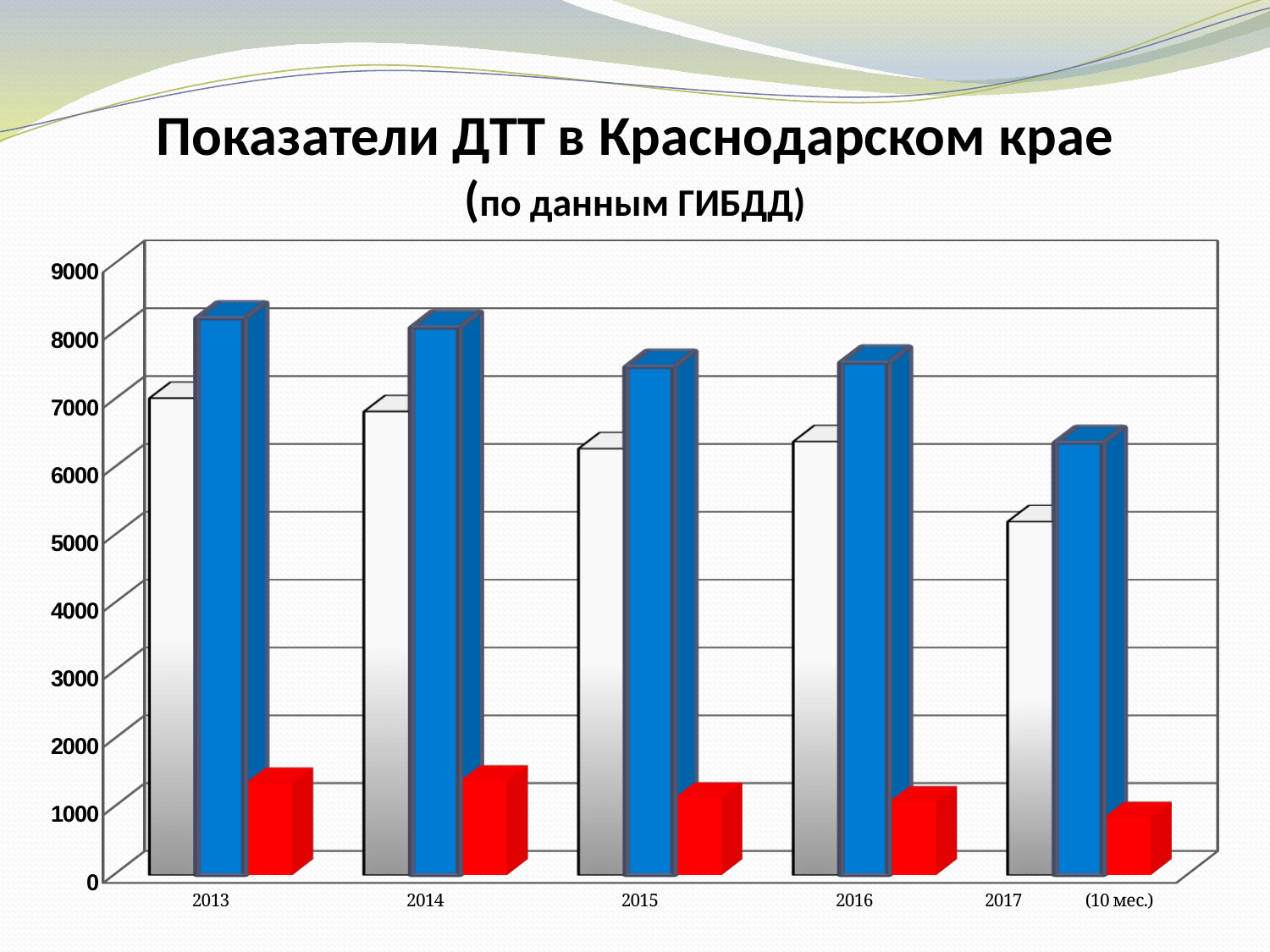
How many year categories are shown on the x axis? 5 How many bars are shown for each year? 3 Is the value of the blue bar for 2013 greater or less than 7000? greater In which year is the white bar the lowest? 2017 (10 мес.) Is the value of the red bar for 2013 greater or less than 2000? less Is the value of the white bar for 2017 (10 мес.) greater or less than 6000? less In 2013, which is larger: the blue bar or the white bar? the blue bar Do the blue bars generally rise or fall from 2013 to 2017? fall What kind of chart is shown on the slide? bar chart In which year is the blue bar the highest? 2013 In which year is the red bar the lowest? 2017 (10 мес.) In which year is the blue bar the lowest? 2017 (10 мес.)